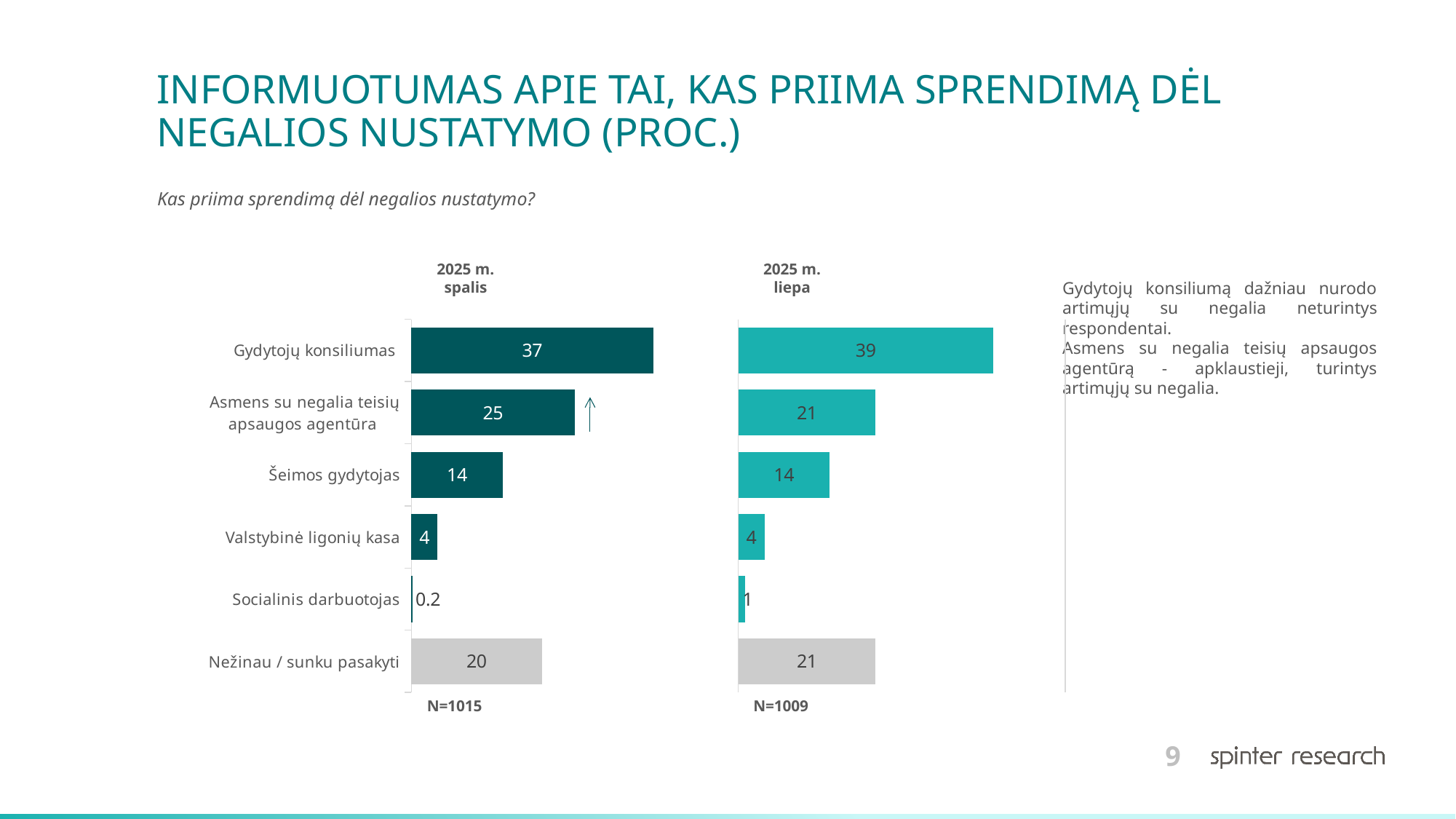
What is the sample size (N) shown under the 2025 m. liepa chart? N=1009 What type of chart is the 2025 m. liepa chart? Bar chart In the 2025 m. liepa chart, which is larger: Šeimos gydytojas or Valstybinė ligonių kasa? Šeimos gydytojas In the 2025 m. spalis chart, what is the difference between Gydytojų konsiliumas and Šeimos gydytojas? 23 Which is larger: Gydytojų konsiliumas in the 2025 m. spalis chart or in the 2025 m. liepa chart? 2025 m. liepa In the 2025 m. liepa chart, which category has the highest value? Gydytojų konsiliumas In the 2025 m. liepa chart, what is the value for Asmens su negalia teisių apsaugos agentūra? 21 In the 2025 m. spalis chart, what is the value for Socialinis darbuotojas? 0.2 How many categories are shown in the 2025 m. spalis chart? 6 What is the difference between the Asmens su negalia teisių apsaugos agentūra values in the 2025 m. spalis chart and the 2025 m. liepa chart? 4 In the 2025 m. spalis chart, which category has the lowest value? Socialinis darbuotojas In the 2025 m. spalis chart, what is the value for Gydytojų konsiliumas? 37